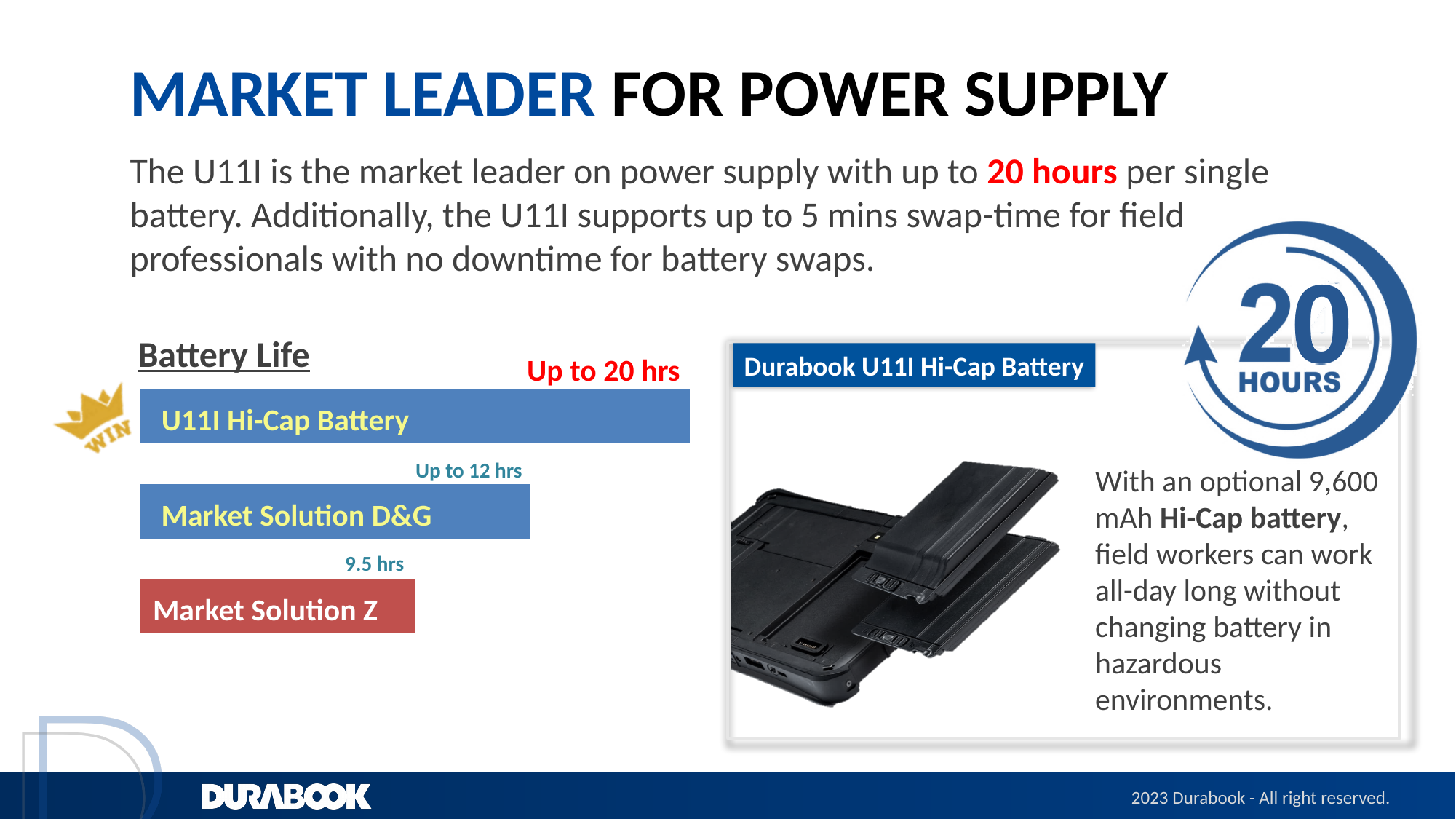
Which category has the shortest battery life in the Battery Life chart? Market Solution Z How many categories are shown in the Battery Life chart? 3 What kind of chart is the Battery Life chart? Bar chart What is the battery life shown for the U11I Hi-Cap Battery in the Battery Life chart? Up to 20 hrs What is the battery life shown for Market Solution Z in the Battery Life chart? 9.5 hrs How many hours longer is Market Solution D&G's battery life than Market Solution Z's in the Battery Life chart? 2.5 hrs What is the battery life shown for Market Solution D&G in the Battery Life chart? Up to 12 hrs In the Battery Life chart, which bar is coloured red rather than blue? Market Solution Z In the Battery Life chart, which has a longer battery life: Market Solution D&G or Market Solution Z? Market Solution D&G Which category has the longest battery life in the Battery Life chart? U11I Hi-Cap Battery What is the title of the chart on the left of the slide? Battery Life How many hours longer is the U11I Hi-Cap Battery's battery life than Market Solution D&G's in the Battery Life chart? 8 hrs